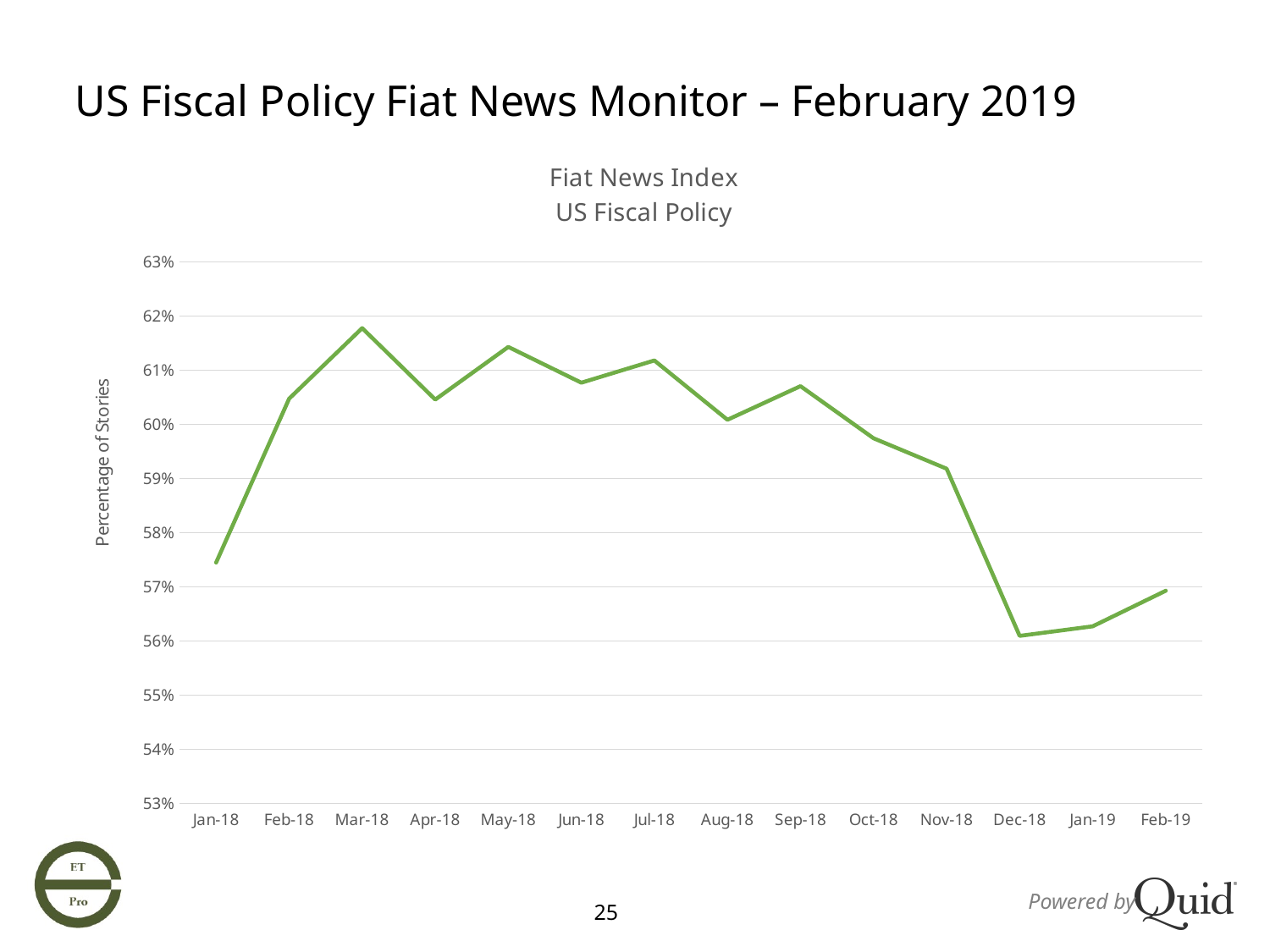
Is the value for Jan-19 greater or less than 57%? less Is the value for Mar-18 greater or less than 61%? greater Is the value for Jan-18 greater or less than 58%? less Which is larger, the value for Mar-18 or the value for Jan-18? Mar-18 What is the label on the y axis? Percentage of Stories How many months are plotted on the x axis? 14 Which month has the highest percentage of stories? Mar-18 Which is larger, the value for Nov-18 or the value for Feb-19? Nov-18 What kind of chart is shown on the slide? Line chart Do the values rise or fall from Sep-18 to Dec-18? fall